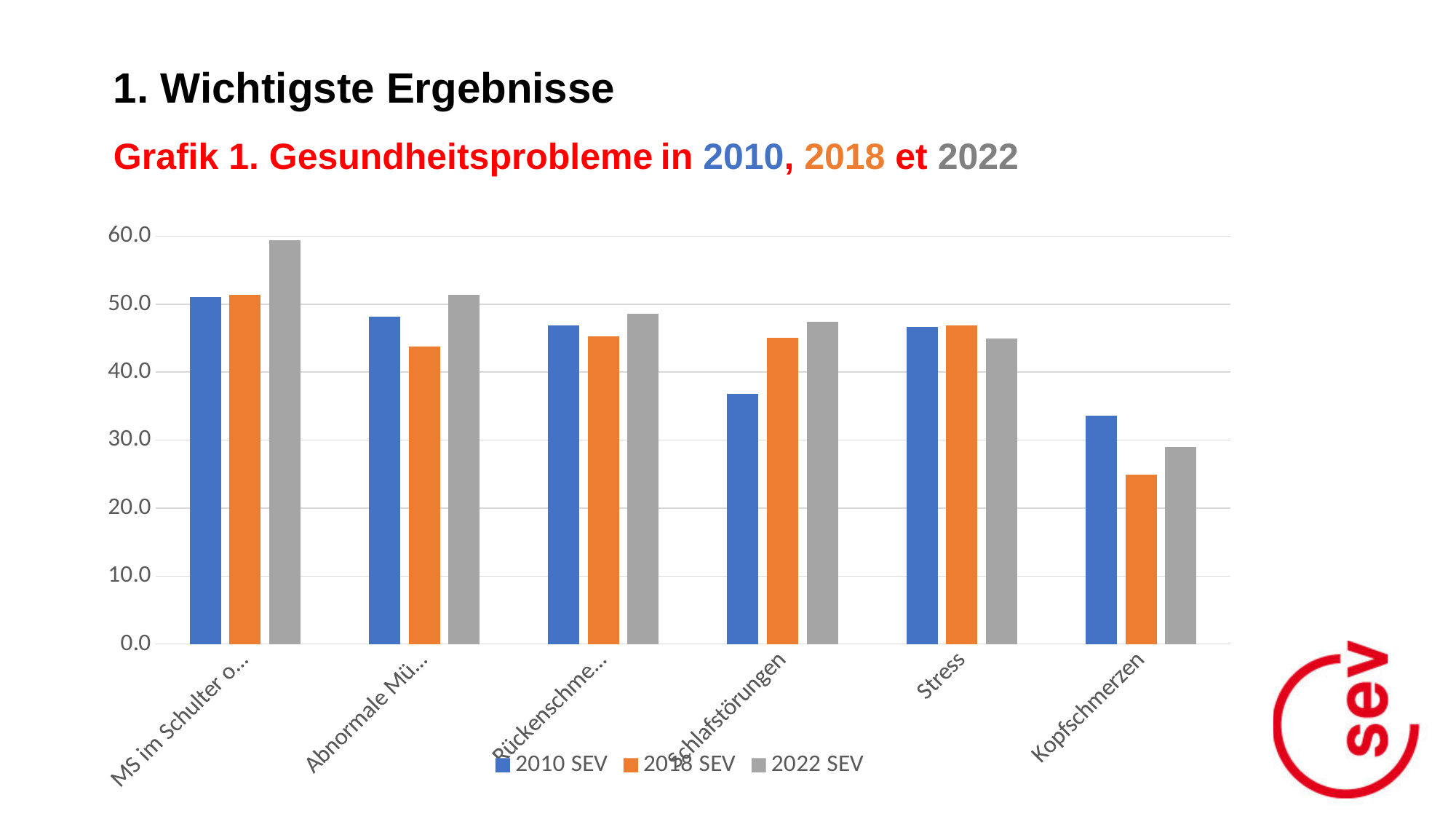
For Kopfschmerzen, which series has the highest value? 2010 SEV How many categories are shown on the x axis? 6 What kind of chart is shown on the slide? bar chart For Schlafstörungen, which is larger: the 2010 SEV value or the 2018 SEV value? 2018 SEV Is the 2010 SEV value for Schlafstörungen greater or less than 40? less Is the 2010 SEV value for Kopfschmerzen greater or less than 30? greater Which series does the legend list first? 2010 SEV Is the 2022 SEV value for Stress greater or less than 50? less How many series does the legend list? 3 For Kopfschmerzen, which is larger: the 2018 SEV value or the 2022 SEV value? 2022 SEV Which category has the lowest 2018 SEV value? Kopfschmerzen